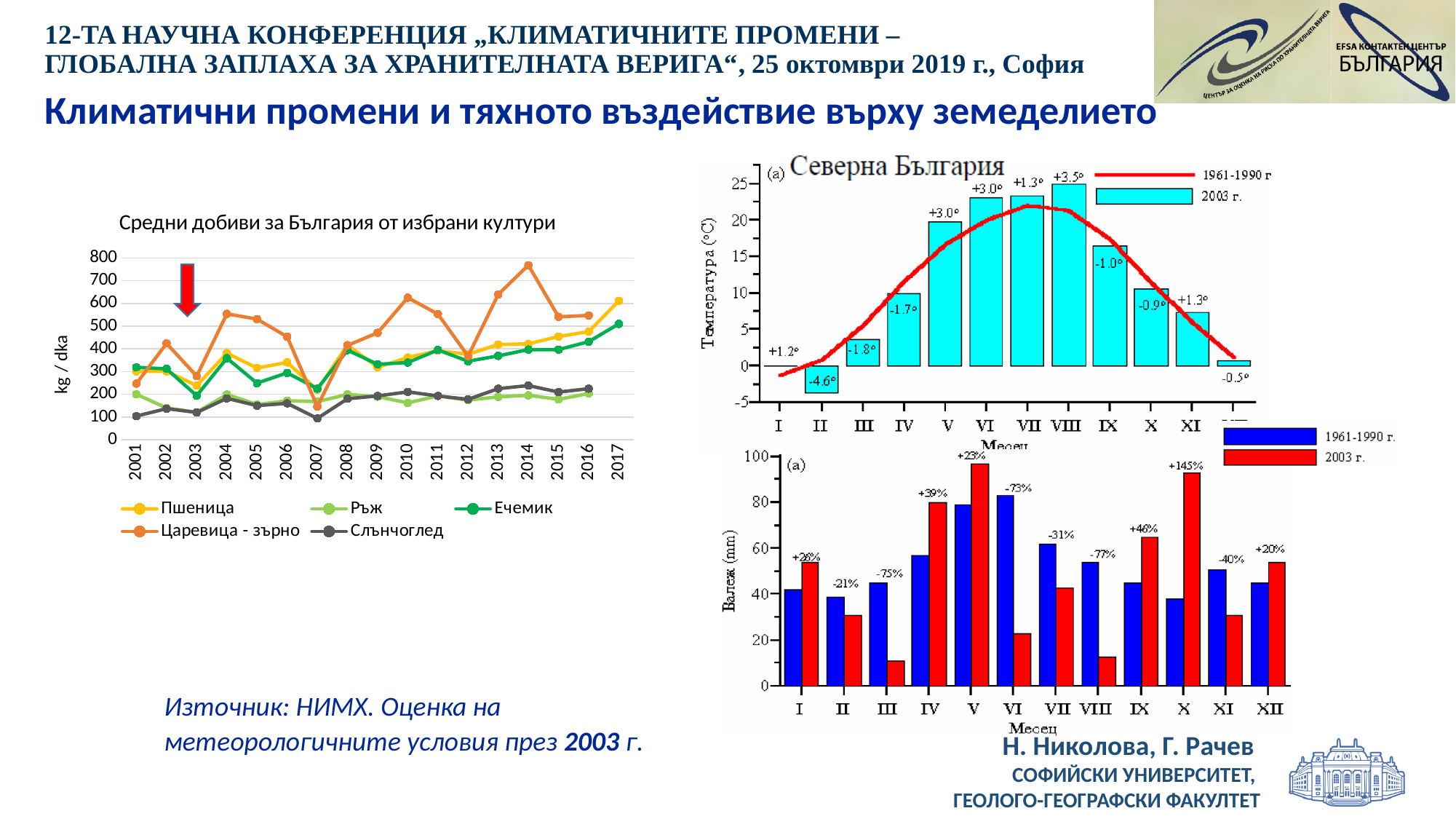
In the 'Северна България' temperature chart, what anomaly is labelled for month II? -4.6° What kind of chart is the 'Средни добиви за България от избрани култури' chart? line chart In the bottom-right precipitation chart, which is larger for month VI: the 1961-1990 г. bar or the 2003 г. bar? 1961-1990 г. How many series does the legend of the 'Средни добиви за България от избрани култури' chart list? 5 How many months are shown on the x axis of the bottom-right precipitation chart? 12 In the 'Северна България' temperature chart, is the 2003 bar for month VIII greater or less than 20? greater In the bottom-right precipitation chart, which month has the lowest percentage label? VIII In the 'Средни добиви за България от избрани култури' chart, which crop reaches the highest yield in 2014? Царевица - зърно In the bottom-right precipitation chart, what percentage label is shown for month X? +145% In the 'Северна България' temperature chart, which month has the largest positive anomaly label? VIII In the 'Средни добиви за България от избрани култури' chart, is the value for Царевица - зърно in 2014 greater or less than 700? greater